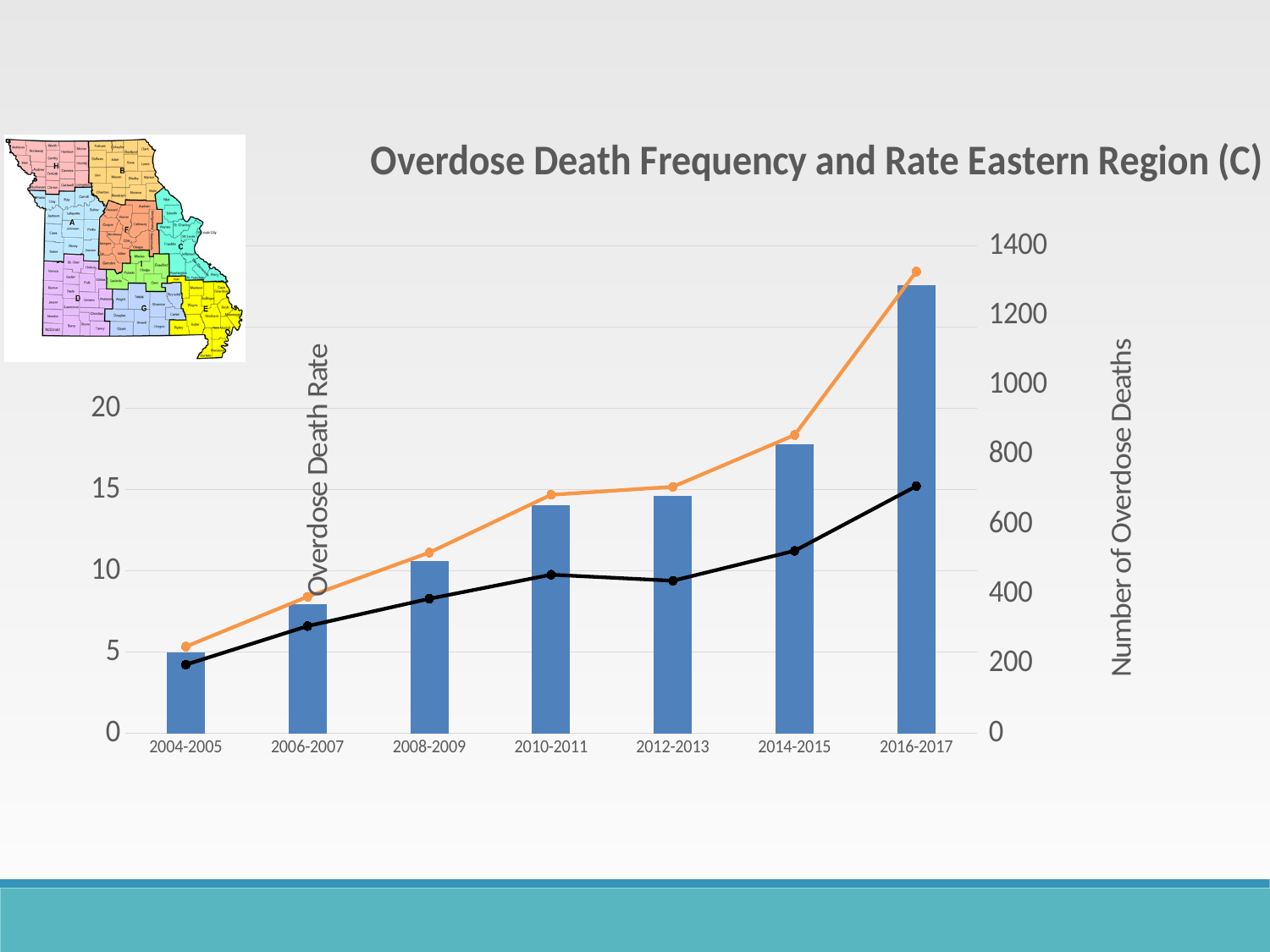
What kind of chart is shown on the slide? A combined bar and line chart Which has the larger number of overdose deaths, 2012-2013 or 2014-2015? 2014-2015 How many time periods are shown on the x axis of the chart? 7 Is the number of overdose deaths for 2014-2015 greater or less than 1000? less Is the orange line's overdose death rate for 2016-2017 greater or less than 15? greater Do the number of overdose deaths generally rise or fall from 2004-2005 to 2016-2017? rise Which time period has the shortest bar for number of overdose deaths? 2004-2005 Is the black line's overdose death rate for 2008-2009 greater or less than 10? less What is the title of the chart? Overdose Death Frequency and Rate Eastern Region (C) Which time period has the tallest bar for number of overdose deaths? 2016-2017